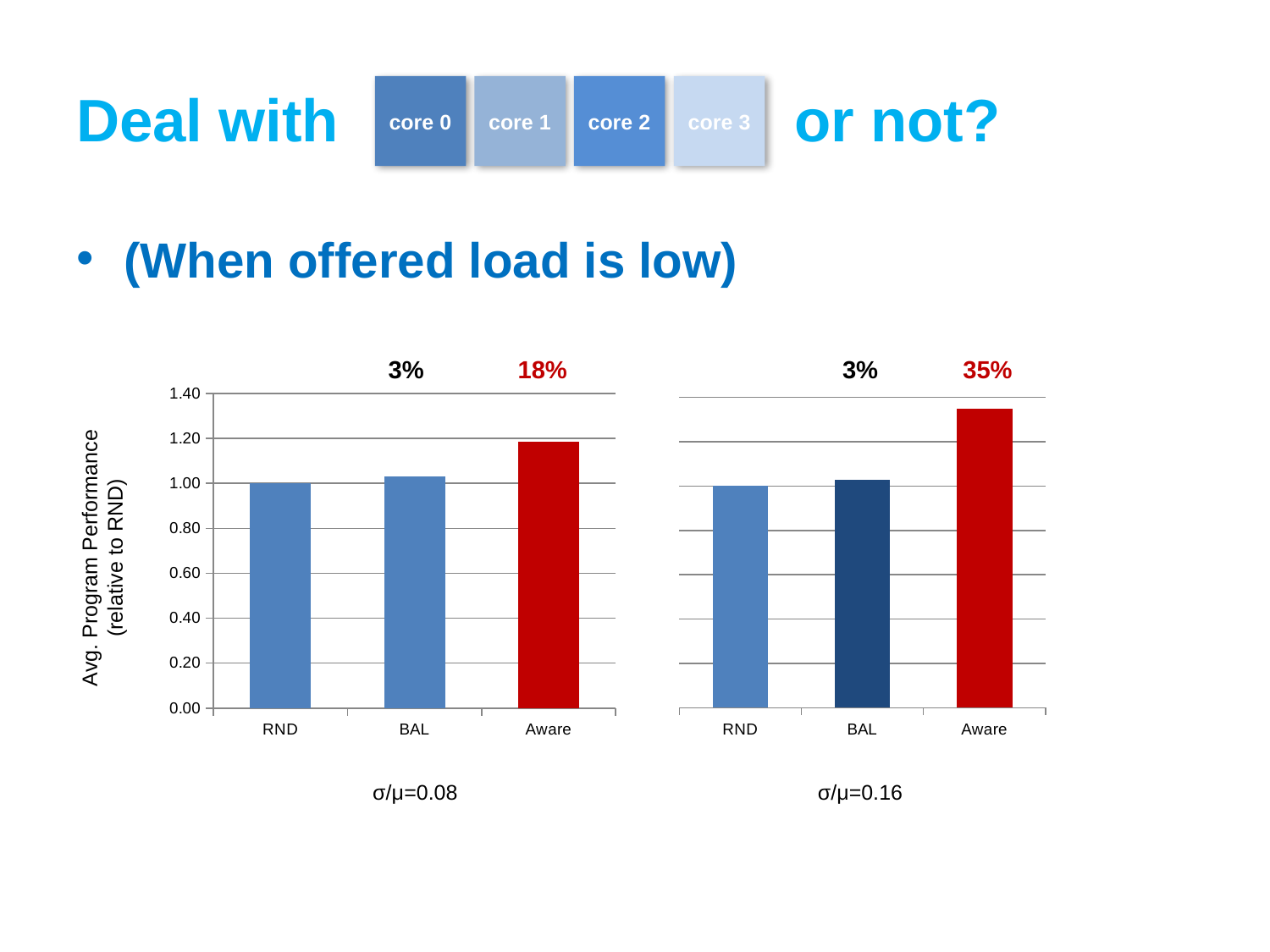
In the σ/μ=0.16 chart, what percentage is printed above the Aware bar? 35% In the σ/μ=0.08 chart, what is the value for RND? 1.00 In the σ/μ=0.08 chart, what percentage is printed above the Aware bar? 18% In the σ/μ=0.08 chart, which category has the highest bar? Aware In the σ/μ=0.16 chart, which is larger, the value for Aware or the value for BAL? Aware In the σ/μ=0.08 chart, what kind of chart is shown? bar chart In the σ/μ=0.16 chart, is the value for Aware greater or less than 1.20? greater In the σ/μ=0.08 chart, is the value for Aware greater or less than 1.00? greater In the σ/μ=0.08 chart, which category has the lowest bar? RND In the σ/μ=0.16 chart, which category has the highest bar? Aware In the σ/μ=0.08 chart, how many categories are plotted on the x axis? 3 What is the y-axis label of the σ/μ=0.08 chart? Avg. Program Performance (relative to RND)